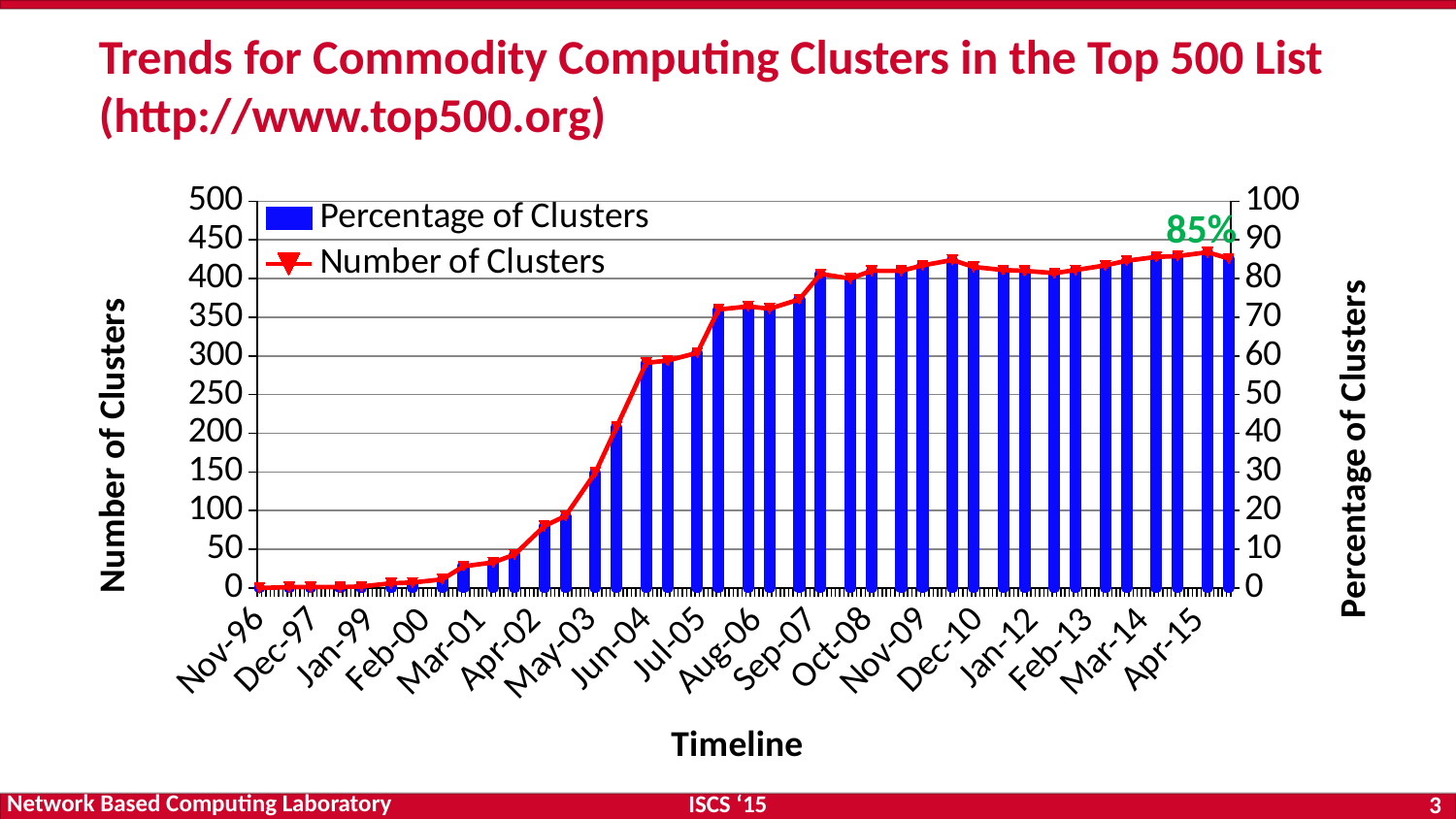
What kind of chart is shown on the slide? Combined bar and line chart Which has the larger Number of Clusters, Mar-01 or Jun-04? Jun-04 Does the Number of Clusters generally rise or fall along the timeline from Nov-96 to Apr-15? Rise Is the Number of Clusters at Jun-04 greater or less than 250? greater Is the Number of Clusters at Apr-15 greater or less than 400? greater Which series is drawn as blue bars according to the legend? Percentage of Clusters What is the title of the left vertical axis? Number of Clusters How many date labels are shown on the x axis? 18 How many series does the legend list? 2 What value is printed as a data label at the right end of the chart? 85% Is the Number of Clusters at Nov-96 greater or less than 50? less